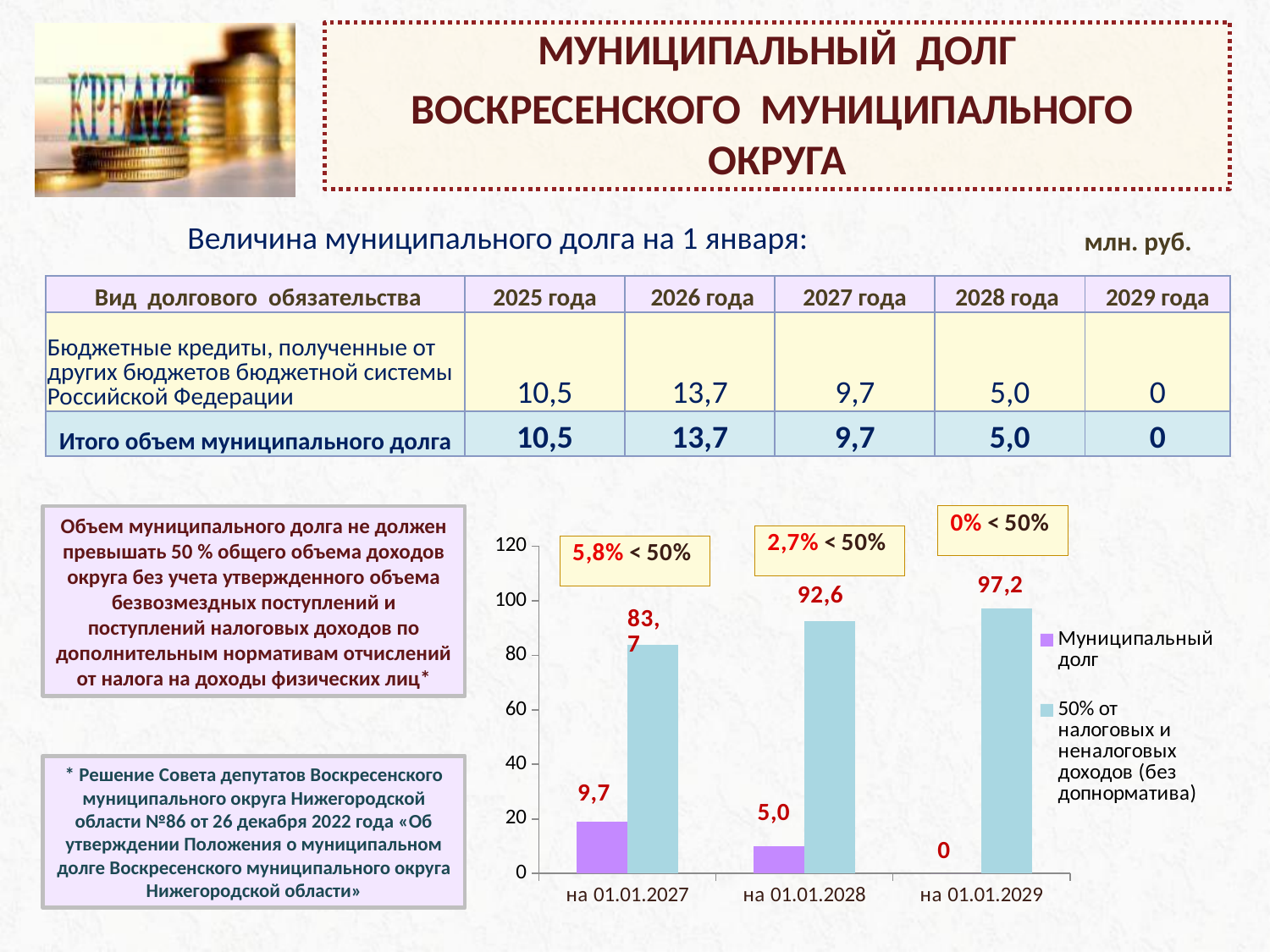
What is the value of Муниципальный долг for на 01.01.2029? 0 Which category has the lowest value for Муниципальный долг? на 01.01.2029 Does the value of 50% от налоговых и неналоговых доходов (без допнорматива) rise or fall from на 01.01.2027 to на 01.01.2029? rise What kind of chart is shown on the slide? bar chart What is the difference between the 50% от налоговых и неналоговых доходов values for на 01.01.2029 and на 01.01.2027? 13,5 How many categories are shown on the x axis of the chart? 3 What is the value of 50% от налоговых и неналоговых доходов (без допнорматива) for на 01.01.2029? 97,2 Which is larger: Муниципальный долг for на 01.01.2027 or for на 01.01.2028? на 01.01.2027 What is the value of 50% от налоговых и неналоговых доходов (без допнорматива) for на 01.01.2028? 92,6 How many series does the chart legend list? 2 Which category has the highest value for 50% от налоговых и неналоговых доходов (без допнорматива)? на 01.01.2029 What is the value of Муниципальный долг for на 01.01.2027? 9,7